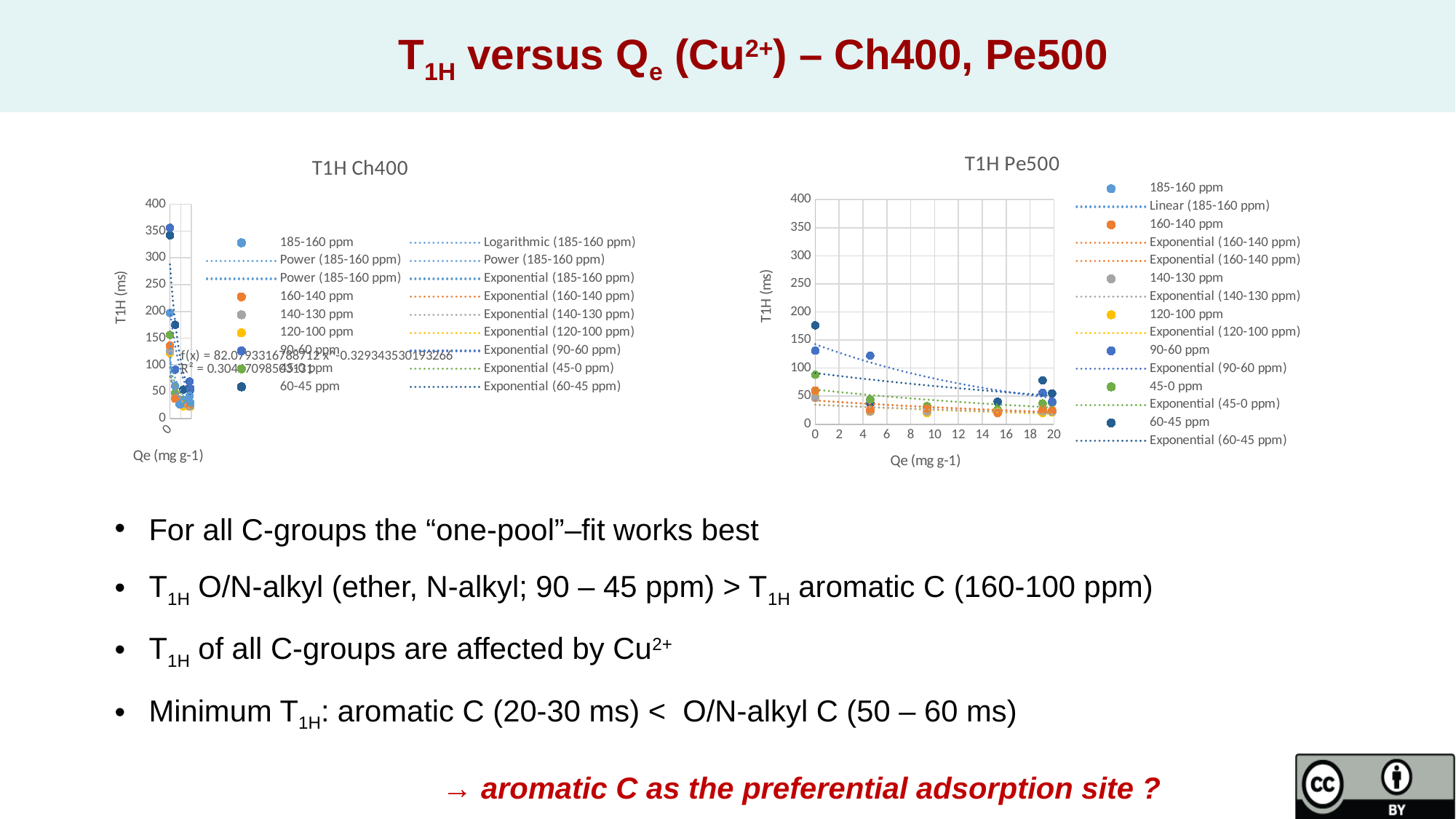
In the 'T1H Pe500' chart, is the value for the 60-45 ppm series at Qe = 0 greater or less than 150? greater What kind of chart is the 'T1H Pe500' chart? scatter chart What is the title of the chart on the left side of the slide? T1H Ch400 In the 'T1H Pe500' chart, which series has the highest value at Qe = 0? 60-45 ppm In the 'T1H Pe500' chart, what is the maximum value shown on the y axis? 400 In the 'T1H Pe500' chart, what is the label of the y axis? T1H (ms) In the 'T1H Pe500' chart, at Qe = 0, is the value for the 60-45 ppm series larger or smaller than the value for the 45-0 ppm series? larger In the 'T1H Ch400' chart, is the highest plotted value for the 185-160 ppm series greater or less than 300? less In the 'T1H Pe500' chart, is the value for the 160-140 ppm series at Qe = 20 greater or less than 50? less In the 'T1H Pe500' chart, how many ppm groups (data series) are plotted? 7